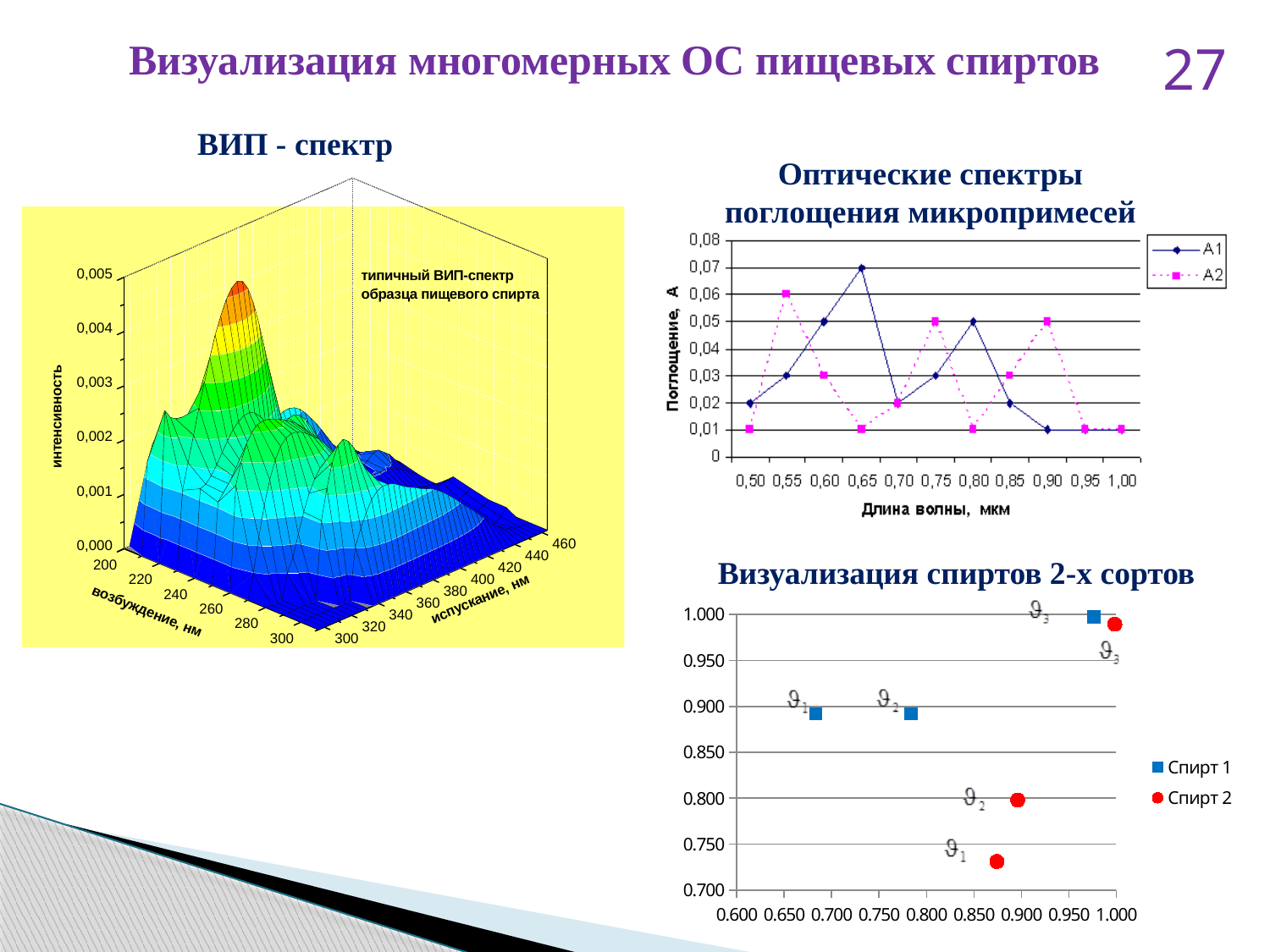
In the 'Визуализация спиртов 2-х сортов' chart, which colour marks the Спирт 1 series? blue In the 'Оптические спектры поглощения микропримесей' chart, at which wavelength does series A2 reach its highest absorption? 0,55 In the 'Оптические спектры поглощения микропримесей' chart, which series has the larger value at wavelength 0,90: A1 or A2? A2 In the 'Оптические спектры поглощения микропримесей' chart, which series has the larger value at wavelength 0,65: A1 or A2? A1 In the 'Оптические спектры поглощения микропримесей' chart, what is the label of the x axis? Длина волны, мкм How many series does the legend of the 'Оптические спектры поглощения микропримесей' chart list? 2 How many series does the legend of the 'Визуализация спиртов 2-х сортов' chart list? 2 In the 'Оптические спектры поглощения микропримесей' chart, at which wavelength does series A1 reach its highest absorption? 0,65 In the 'Визуализация спиртов 2-х сортов' chart, how many points are plotted for Спирт 2? 3 In the 'Оптические спектры поглощения микропримесей' chart, what is the highest absorption value of series A1? 0,07 What kind of chart is the 'Оптические спектры поглощения микропримесей' chart? line chart In the 'Визуализация спиртов 2-х сортов' chart, is the y value of the lowest Спирт 2 point greater or less than 0.750? less